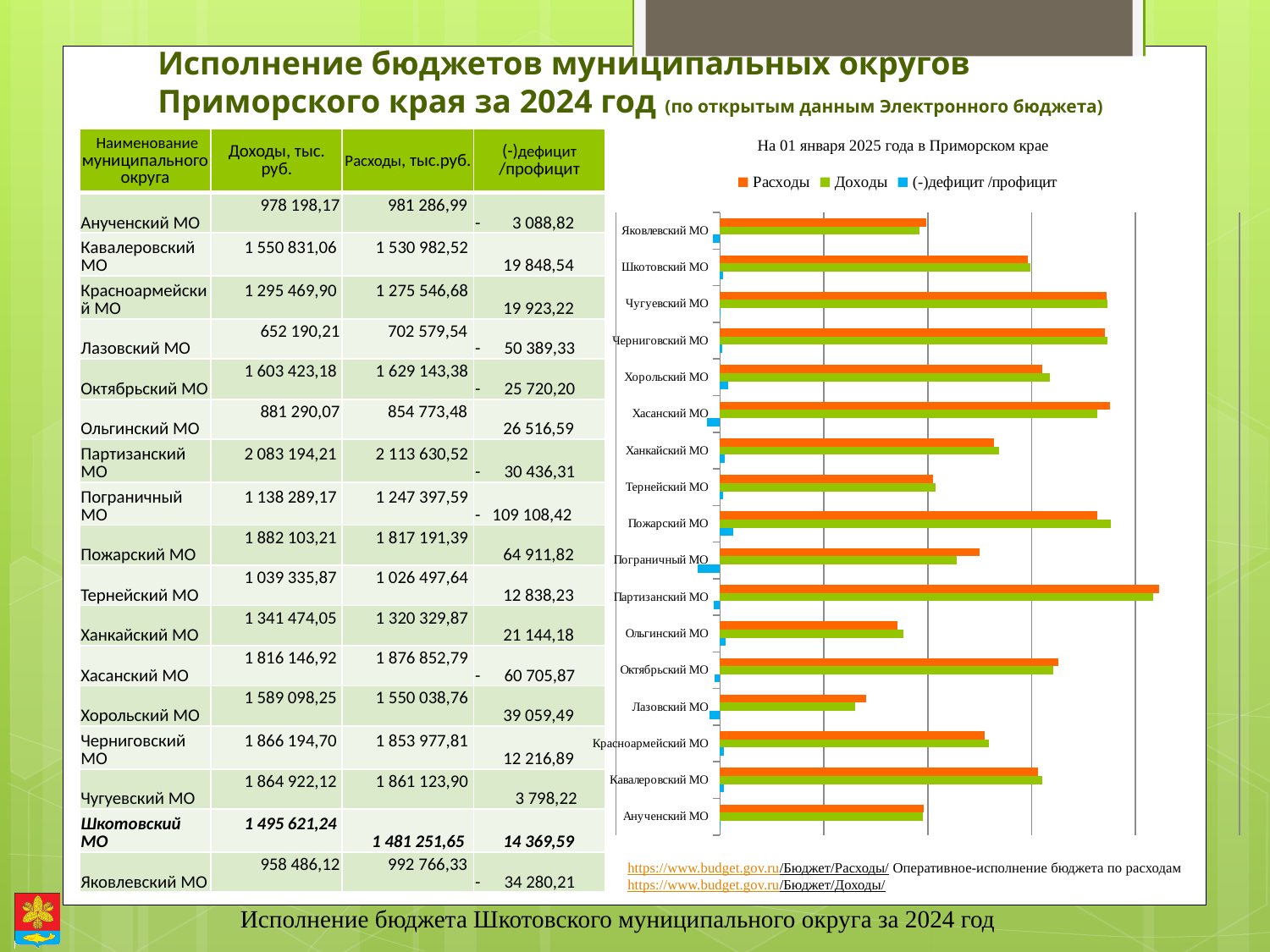
Which has the larger Доходы bar on the chart: Хасанский МО or Тернейский МО? Хасанский МО Which municipal district has the highest Расходы bar on the chart? Партизанский МО What is the title shown above the chart? На 01 января 2025 года в Приморском крае How many series does the legend of the chart list? 3 Which municipal district has the lowest Доходы bar on the chart? Лазовский МО According to the table on the slide, what is the Доходы value (тыс. руб.) for Шкотовский МО? 1 495 621,24 What kind of chart is shown on the right side of the slide? bar chart According to the table on the slide, what is the Расходы value (тыс. руб.) for Лазовский МО? 702 579,54 Using the values printed in the table, by how much do Расходы exceed Доходы for Партизанский МО (тыс. руб.)? 30 436,31 Which series is drawn in orange on the chart? Расходы How many municipal districts (categories) are plotted on the chart? 17 Which has the larger Расходы bar on the chart: Пожарский МО or Ольгинский МО? Пожарский МО